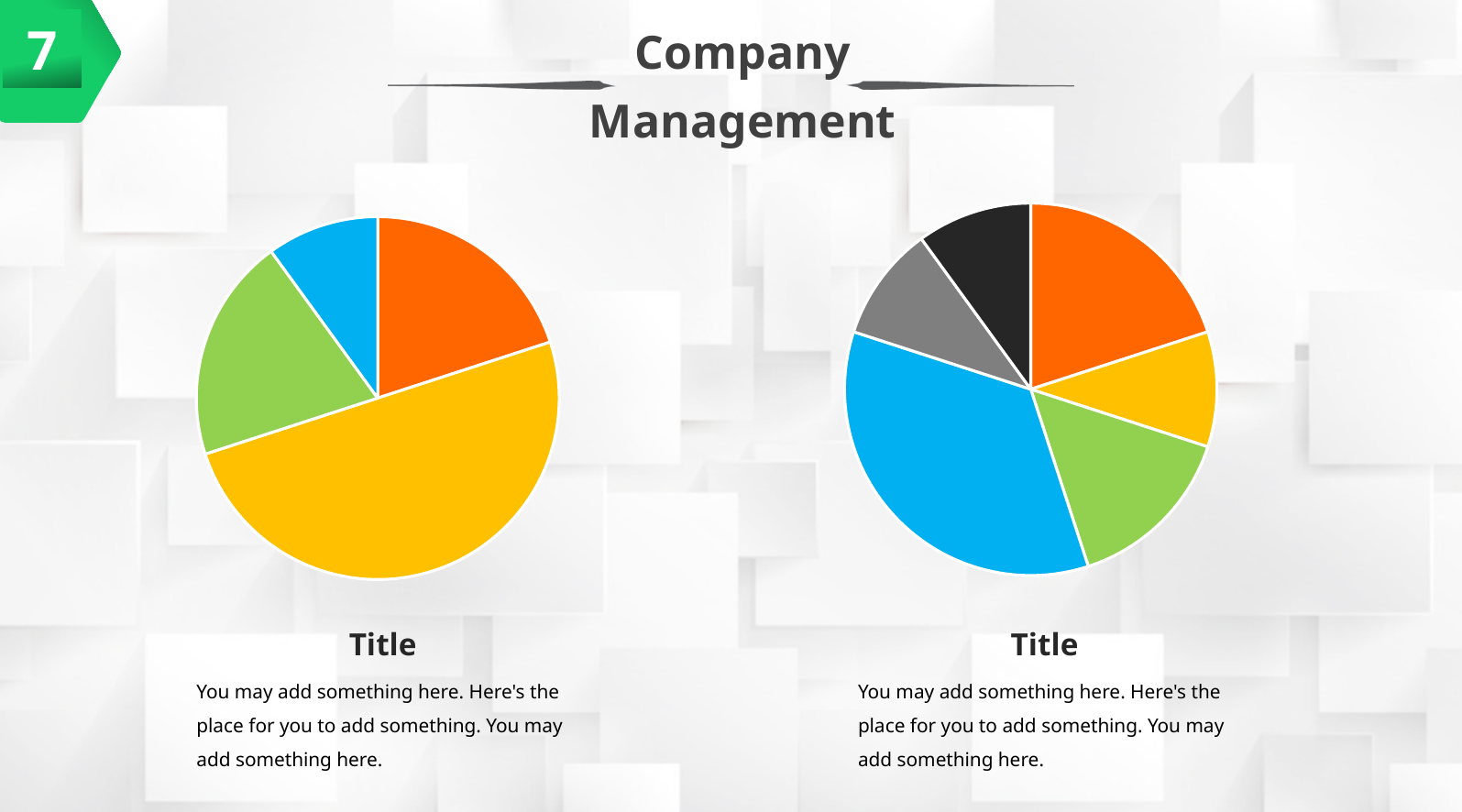
What kind of chart is the right chart on the slide? pie chart In the right pie chart, is the blue slice larger or smaller than the orange slice? larger What kind of chart is the left chart on the slide? pie chart How many slices does the right pie chart have? 6 In the left pie chart, is the orange slice larger or smaller than the blue slice? larger In the left pie chart, which colour slice is the smallest? blue How many slices does the left pie chart have? 4 In the right pie chart, which colour slice is the largest? blue In the left pie chart, which colour slice is the largest? yellow In the left pie chart, is the yellow slice larger or smaller than the green slice? larger What is the title shown at the top of the slide? Company Management Does either pie chart on the slide show a legend? No